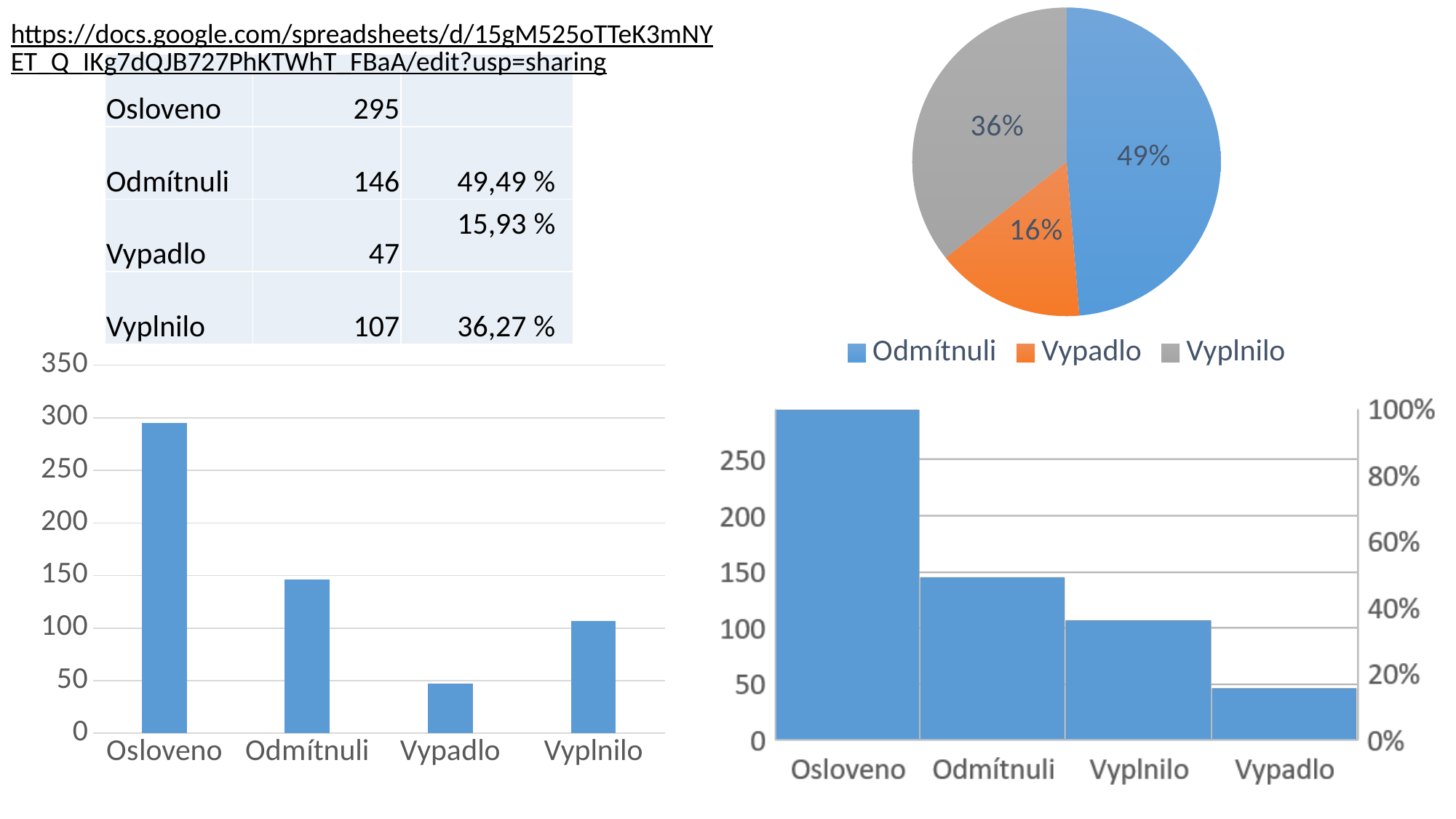
In the bar chart at the bottom left, is the value for Odmítnuli greater or less than 100? greater In the pie chart at the top right, which category has the largest slice? Odmítnuli In the bar chart at the bottom left, which category has the highest bar? Osloveno In the pie chart at the top right, which category has the smallest slice? Vypadlo What kind of chart is shown at the bottom left of the slide? bar chart In the bar chart at the bottom right, do the bar values rise or fall from left to right? fall In the bar chart at the bottom left, which category has the lowest bar? Vypadlo In the bar chart at the bottom right, which is larger, Odmítnuli or Vyplnilo? Odmítnuli In the pie chart at the top right, what share does Vyplnilo have? 36% In the pie chart at the top right, what share does Odmítnuli have? 49% In the pie chart at the top right, what share does Vypadlo have? 16% In the pie chart at the top right, how many entries does the legend list? 3